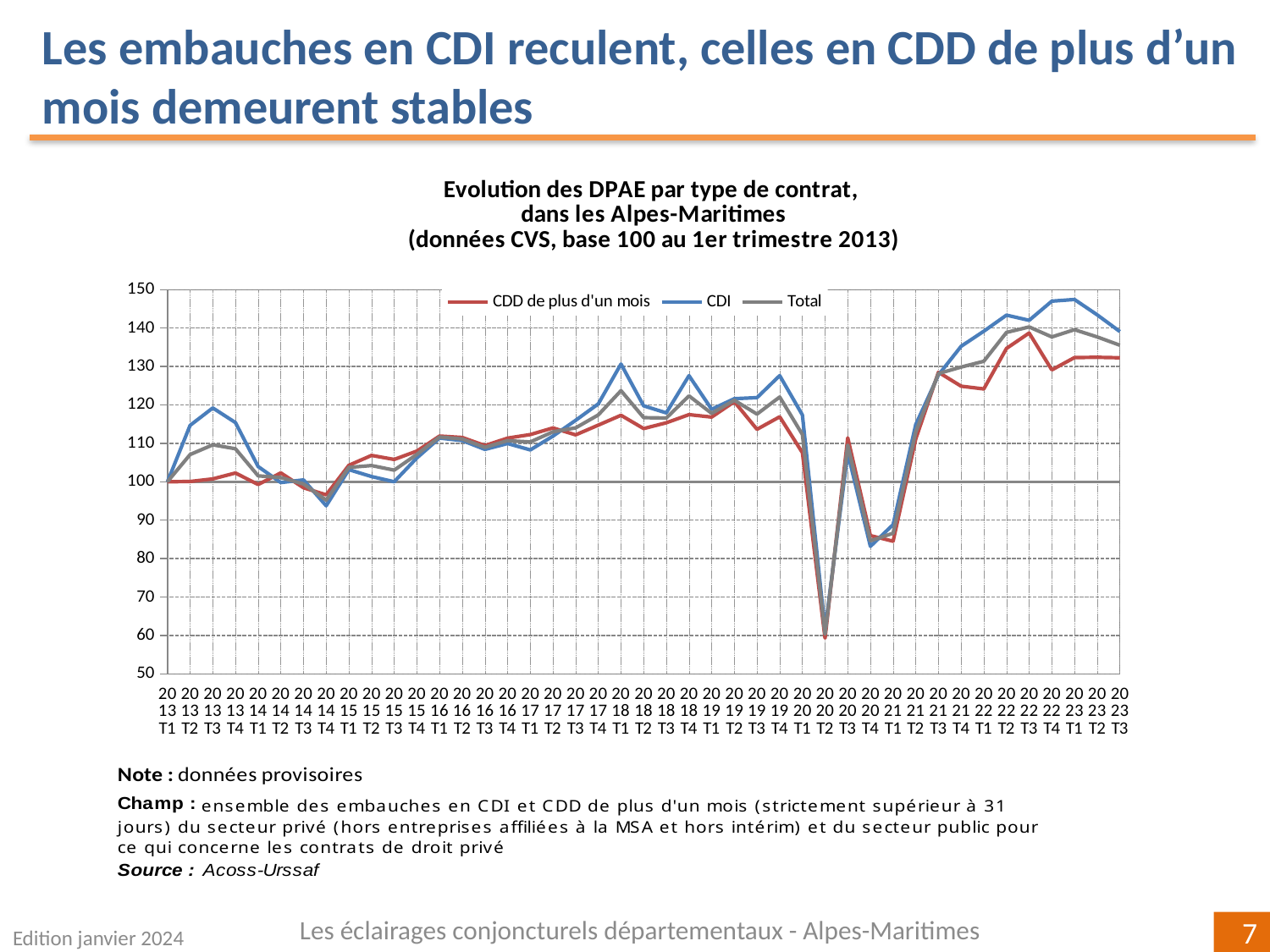
What colour is the CDI line in the chart? blue What is the value of the CDI series at 2013 T1? 100 What kind of chart is shown on the slide? line chart How many quarterly points are plotted along the x axis? 43 Is the value of the CDI series at 2020 T2 greater or less than 80? less At which quarter does the CDI series reach its lowest value? 2020 T2 Is the value of the CDI series at 2023 T1 greater or less than 140? greater At 2023 T3, which is larger: the CDI series or the CDD de plus d'un mois series? CDI Does the CDI series rise or fall between 2023 T1 and 2023 T3? fall Which series are listed in the chart legend? CDD de plus d'un mois, CDI, Total How many series does the chart legend list? 3 Is the value of the CDD de plus d'un mois series at 2023 T3 greater or less than 120? greater